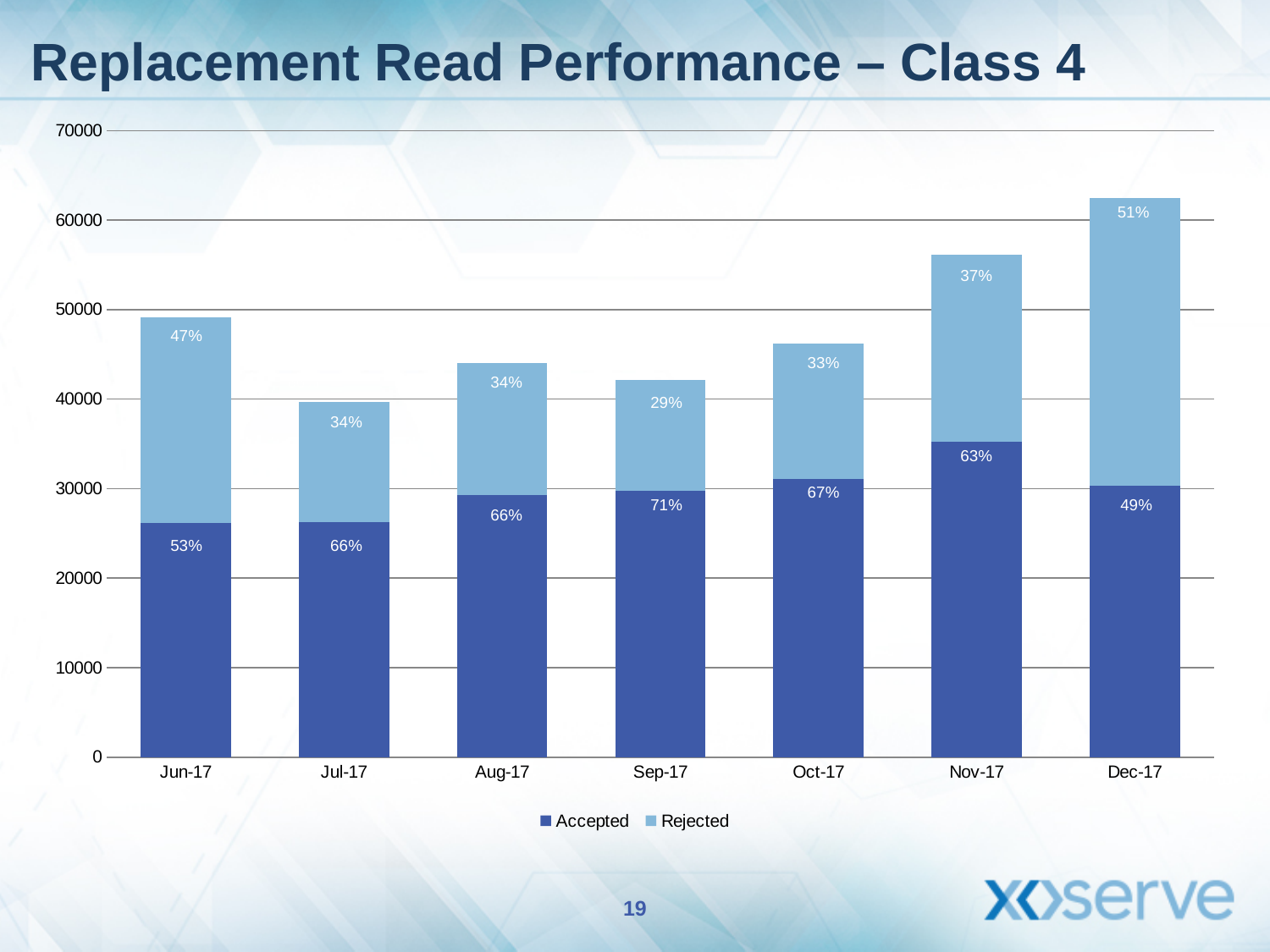
Which month has the shortest stacked bar overall? Jul-17 What is the Rejected percentage label shown for Jun-17? 47% What is the Accepted percentage label shown for Sep-17? 71% Which month has the tallest stacked bar overall? Dec-17 How many months are shown on the x axis? 7 Which month has the highest Accepted percentage label? Sep-17 Which month has the lowest Accepted percentage label? Dec-17 How many series does the legend list? 2 Which is larger, the Rejected percentage label for Jun-17 or for Nov-17? Jun-17 Is the total bar height for Dec-17 greater or less than 60000? greater What is the Rejected percentage label shown for Dec-17? 51%